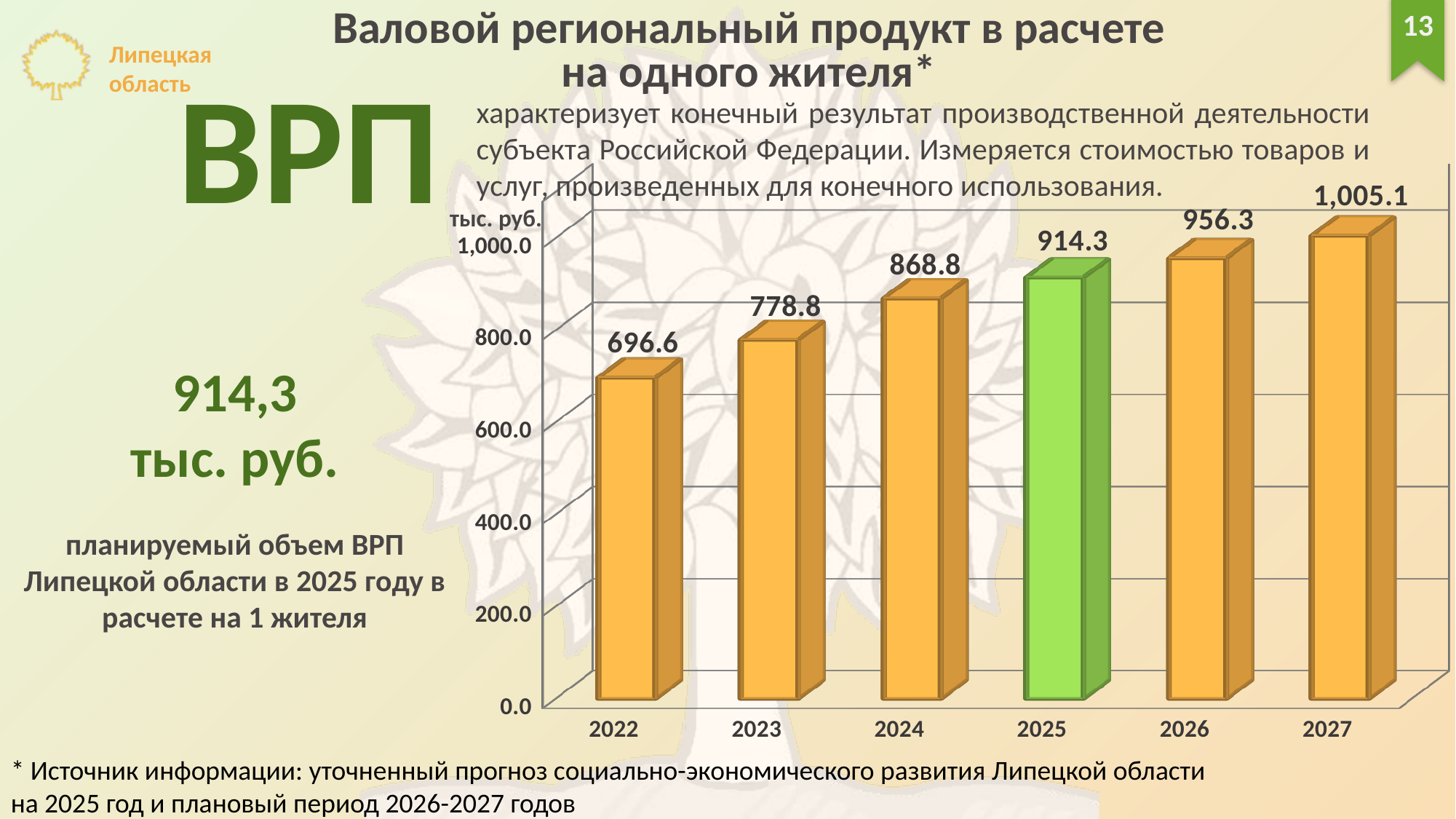
What kind of chart is shown on the slide? bar chart What is the value for 2027 on the chart? 1,005.1 Which year has the lowest value on the chart? 2022 Do the values rise or fall from 2022 to 2027? rise What is the value for 2025 on the chart? 914.3 Which is larger, the value for 2023 or the value for 2024? 2024 How many years are shown on the x axis of the chart? 6 What is the value for 2022 on the chart? 696.6 What is the difference between the values for 2027 and 2022? 308.5 Which year has the highest value on the chart? 2027 Is the value for 2026 greater or less than 1,000.0? less What is the difference between the values for 2025 and 2024? 45.5